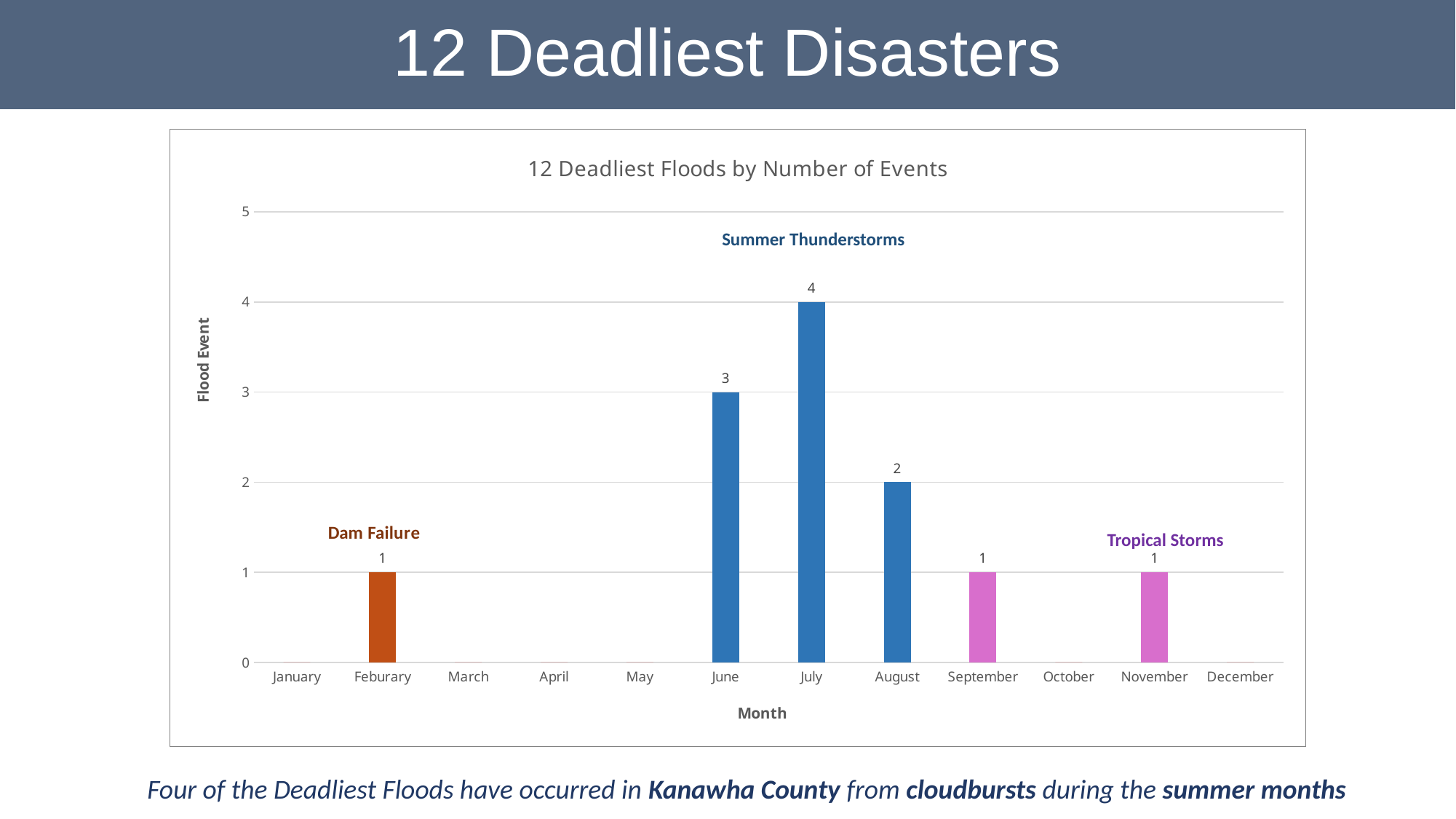
What label is shown above the February bar? Dam Failure Which month has the highest number of flood events? July What kind of chart is shown on the slide? Bar chart What is the value for November? 1 How many months are shown on the x axis? 12 What is the title of the chart? 12 Deadliest Floods by Number of Events What is the difference between the values for June and August? 1 Which is larger, the value for June or the value for August? June What is the value for June? 3 What is the difference between the values for July and June? 1 What is the value for August? 2 What is the value for July? 4